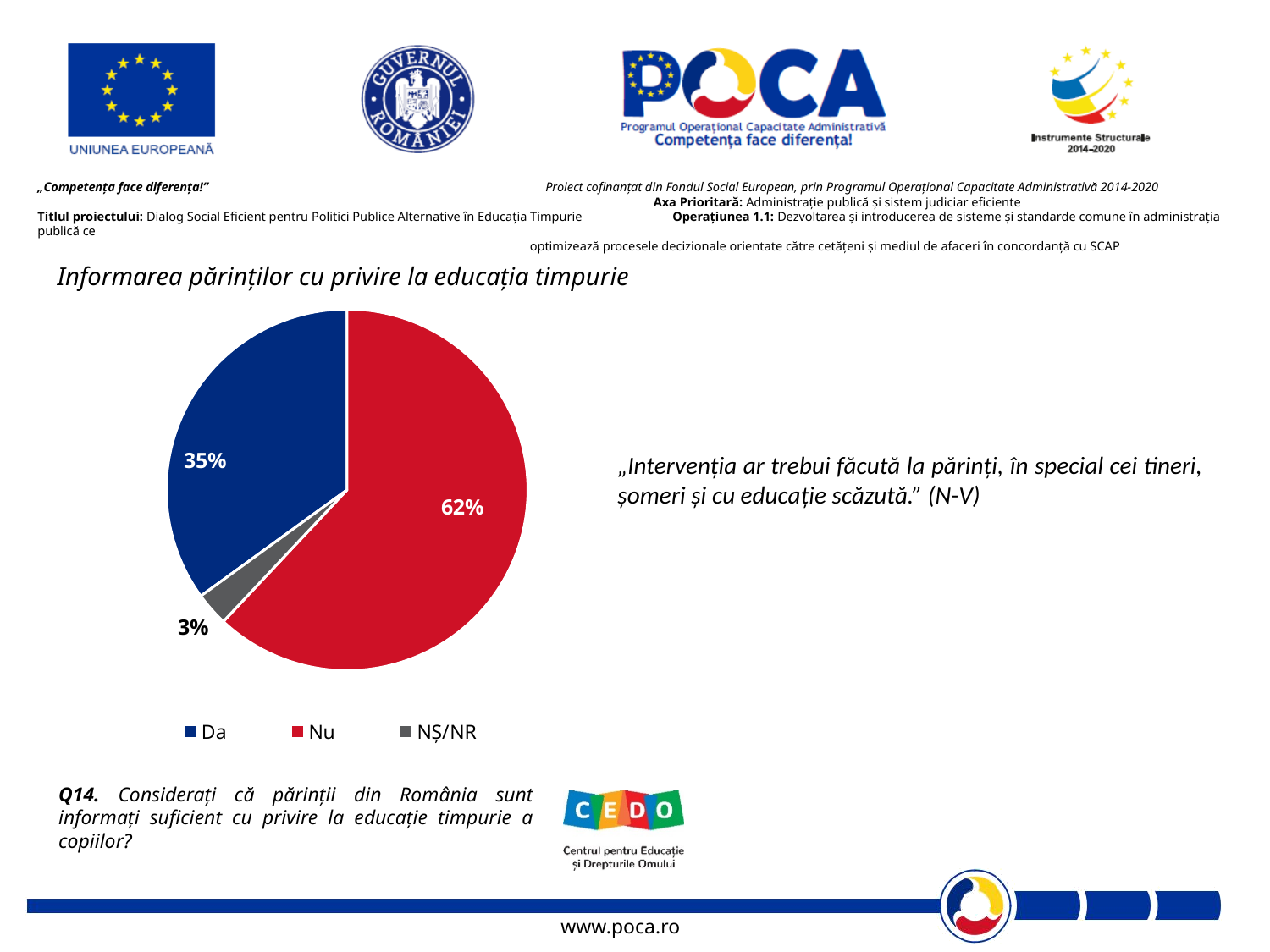
What percentage of respondents answered "NȘ/NR"? 3% What type of chart is shown on the slide? pie chart Which response has the smallest share of the pie? NȘ/NR What percentage of respondents answered "Nu"? 62% How many categories does the pie chart show? 3 What percentage of respondents answered "Da"? 35% How many entries does the legend list? 3 Which is larger, the share for "Da" or the share for "Nu"? Nu Which response has the largest share of the pie? Nu What is the title of the chart? Informarea părinților cu privire la educația timpurie What colour is the "Da" slice in the pie chart? blue What is the difference in percentage points between the "Nu" and "Da" slices? 27